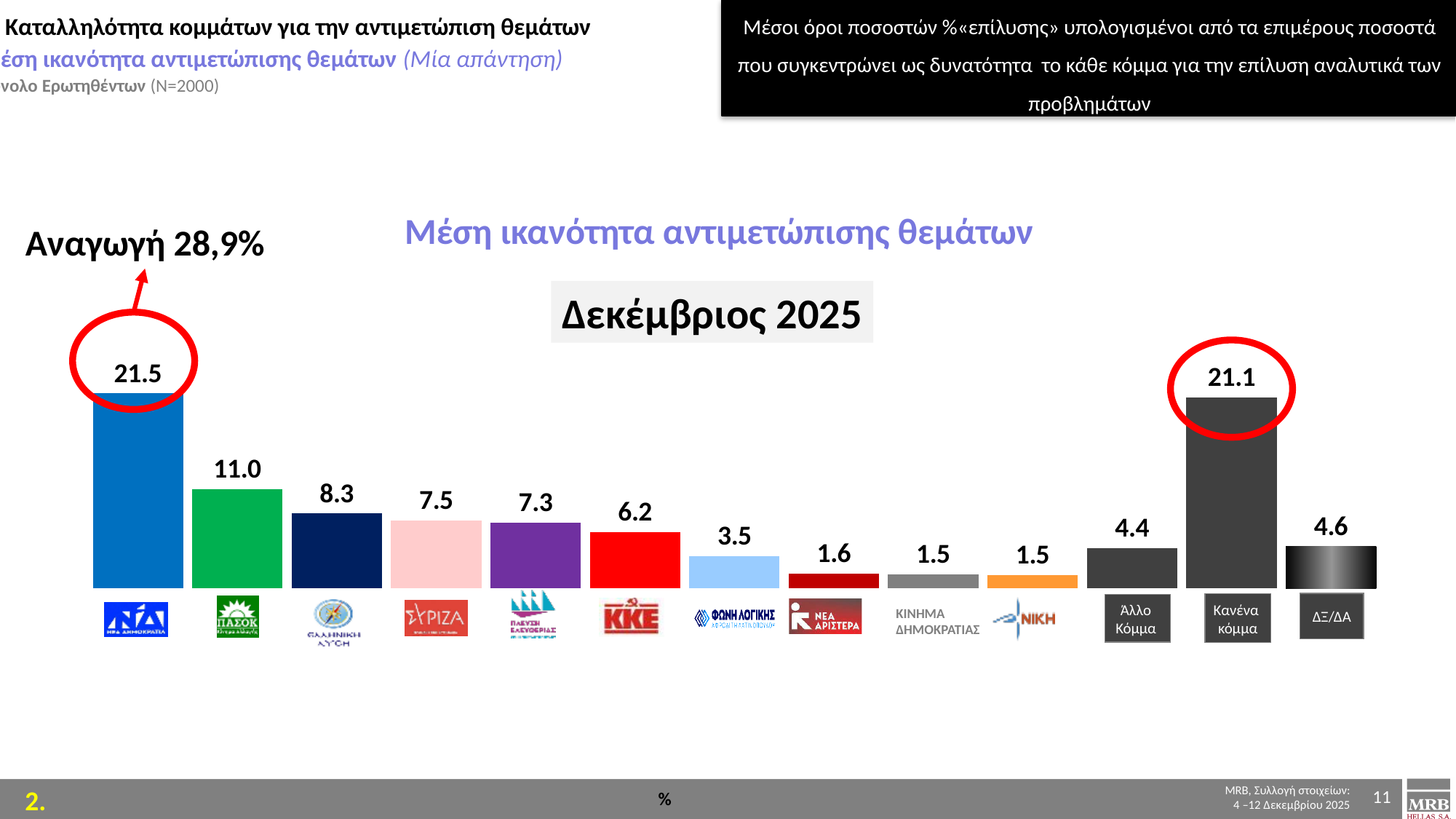
What is the difference between the values for ΝΔ and 'Κανένα κόμμα'? 0.4 What value is shown for the 'Κανένα κόμμα' bar? 21.1 What is the difference between the values for ΠΑΣΟΚ and ΣΥΡΙΖΑ? 3.5 What value is shown for ΣΥΡΙΖΑ in the chart? 7.5 Which bar has the highest value in the chart? ΝΔ (Νέα Δημοκρατία) What value is shown for ΠΑΣΟΚ in the chart? 11.0 What value is shown for ΔΞ/ΔΑ in the chart? 4.6 Which is larger, the value for 'Άλλο Κόμμα' or the value for ΔΞ/ΔΑ? ΔΞ/ΔΑ What is the 'Αναγωγή' percentage annotated above the ΝΔ bar? 28,9% What value is shown for ΚΚΕ in the chart? 6.2 What kind of chart is shown on the slide? Bar chart How many bars are plotted in the chart? 13